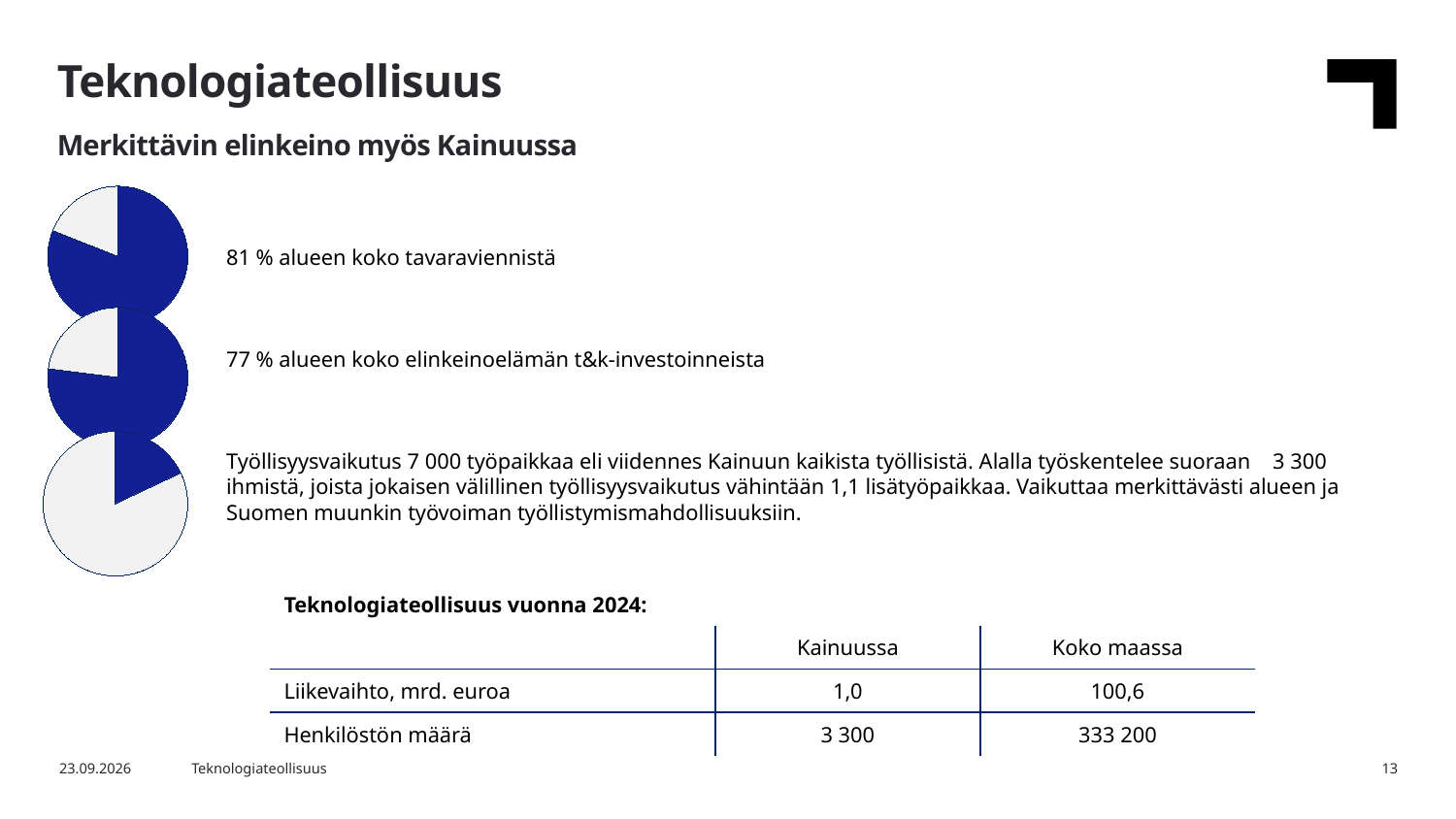
Is the blue slice in the bottom pie chart greater or less than 50 %? Less Is the blue slice larger in the top pie chart (goods exports) or in the middle pie chart (R&D investments)? Top pie chart What kind of charts are shown on the left side of the slide? Pie charts What is the difference in percentage points between the blue share in the top pie chart (81 %) and the middle pie chart (77 %)? 4 percentage points How many slices does each pie chart have? 2 Which pie chart has the smallest blue slice: the top, middle or bottom one? Bottom Which pie chart has the largest blue slice: the top, middle or bottom one? Top In the middle pie chart, what share of the region's business R&D investments (t&k-investoinnit) does the blue slice represent? 77 % How many pie charts are on the slide? 3 What colour is the highlighted slice in the pie charts? Blue In the top pie chart, what share of the region's total goods exports (tavaravienti) does the blue slice represent? 81 % Is the blue slice larger in the middle pie chart or in the bottom pie chart? Middle pie chart